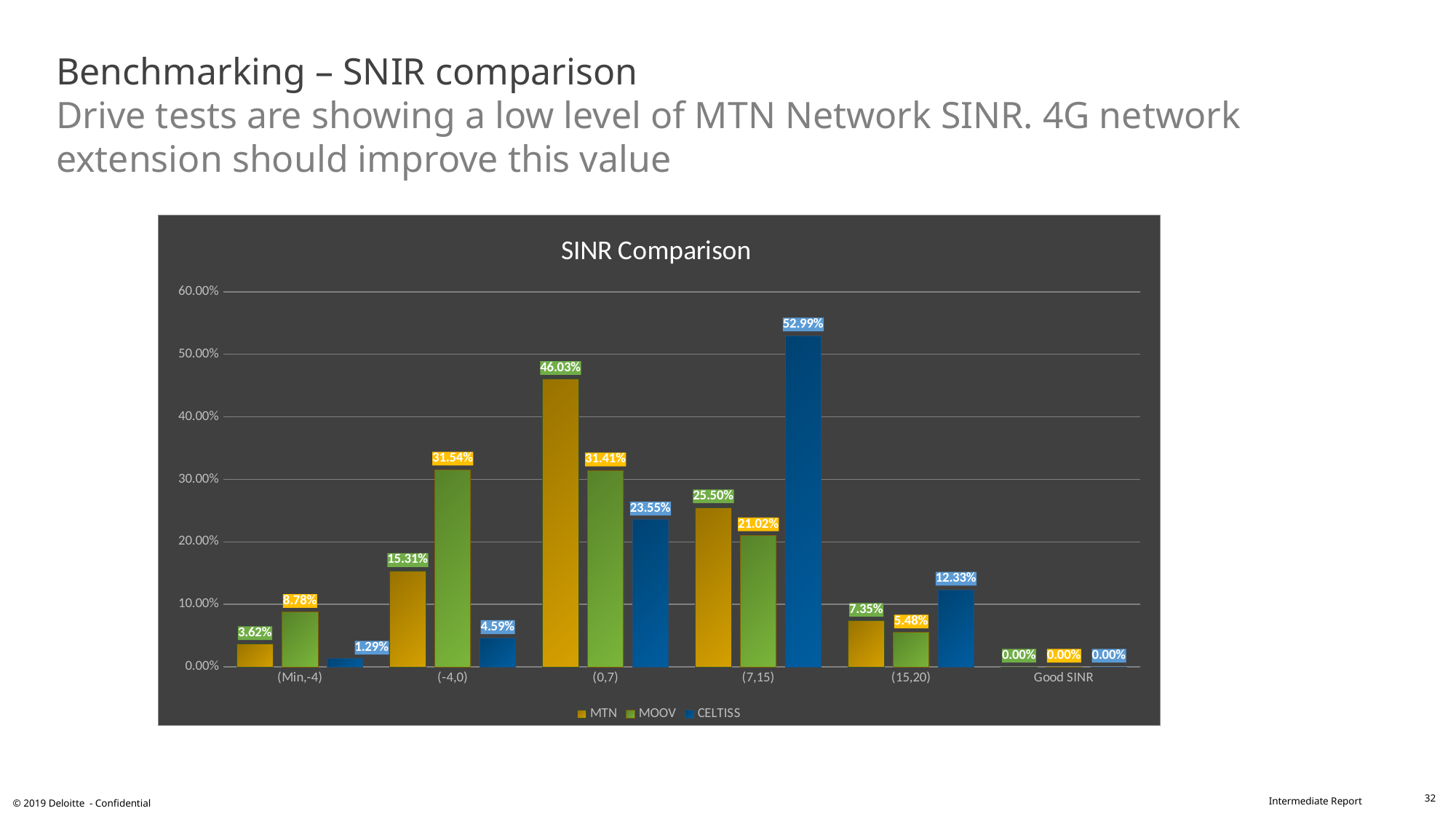
What is the value for MTN in the (0,7) category? 46.03% What kind of chart is shown on the slide? Bar chart Which category has the highest value for MTN? (0,7) Which category has the lowest value for CELTISS, excluding Good SINR? (Min,-4) How many series does the legend list? 3 What is the value for CELTISS in the (15,20) category? 12.33% Which is larger in the (7,15) category, the MTN value or the CELTISS value? CELTISS What is the title of the chart? SINR Comparison What is the value for CELTISS in the (7,15) category? 52.99% How many categories are shown on the x axis? 6 What is the value for MOOV in the (-4,0) category? 31.54% What is the difference between the MTN and MOOV values in the (0,7) category? 14.62%